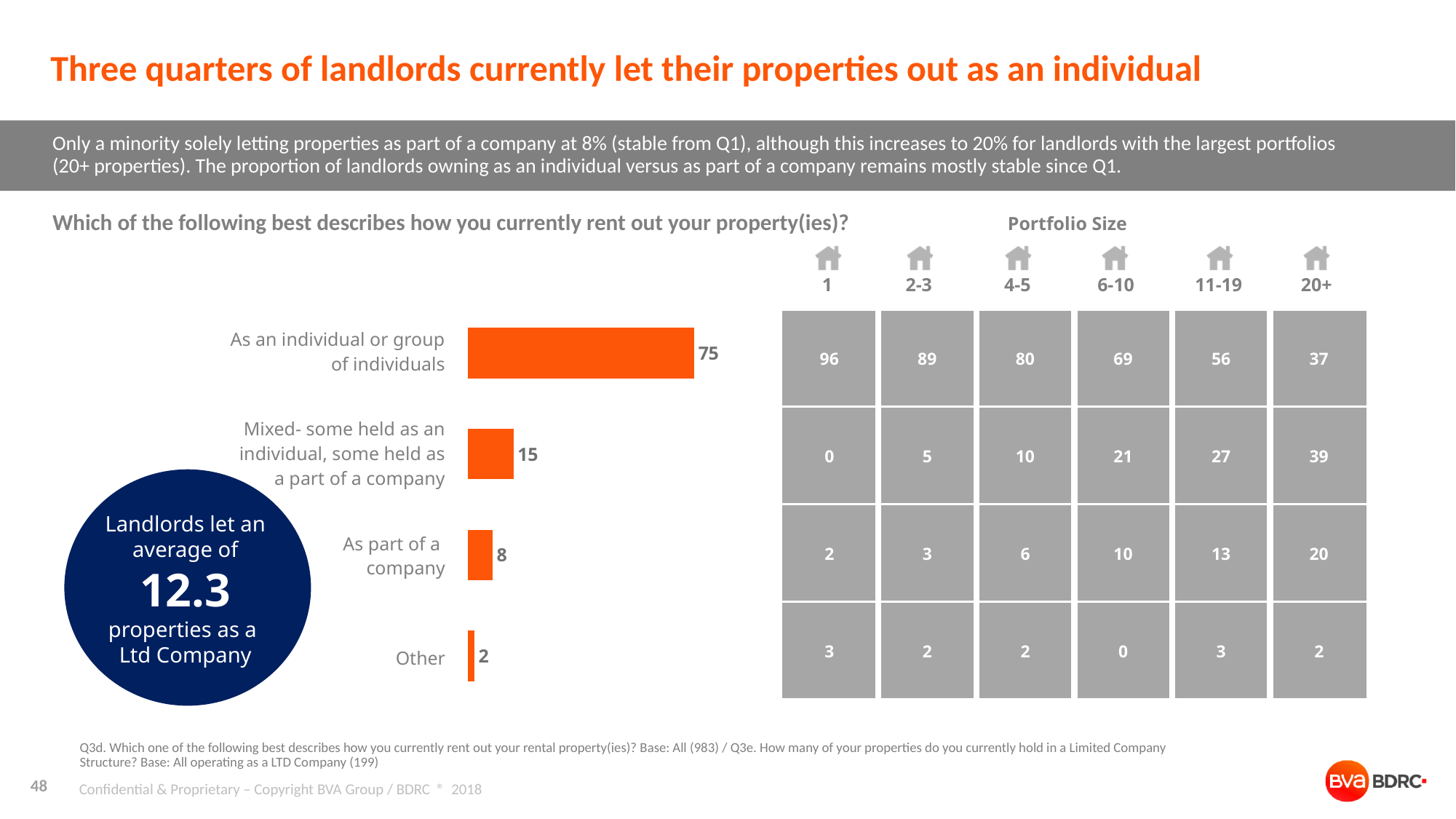
What type of chart is used to show how landlords currently rent out their properties? Bar chart Which category has the highest value in the bar chart? As an individual or group of individuals Which is larger in the bar chart: 'Mixed- some held as an individual, some held as a part of a company' or 'As part of a company'? Mixed- some held as an individual, some held as a part of a company What is the difference between the values for 'As part of a company' and 'Other'? 6 Which category has the lowest value in the bar chart? Other What is the value for 'Mixed- some held as an individual, some held as a part of a company' in the bar chart? 15 What is the value for 'As part of a company' in the bar chart? 8 What is the value for 'As an individual or group of individuals' in the bar chart? 75 What is the value for 'Other' in the bar chart? 2 What is the difference between the values for 'As an individual or group of individuals' and 'Mixed- some held as an individual, some held as a part of a company'? 60 How many categories are shown in the bar chart? 4 What colour are the bars in the chart? Orange